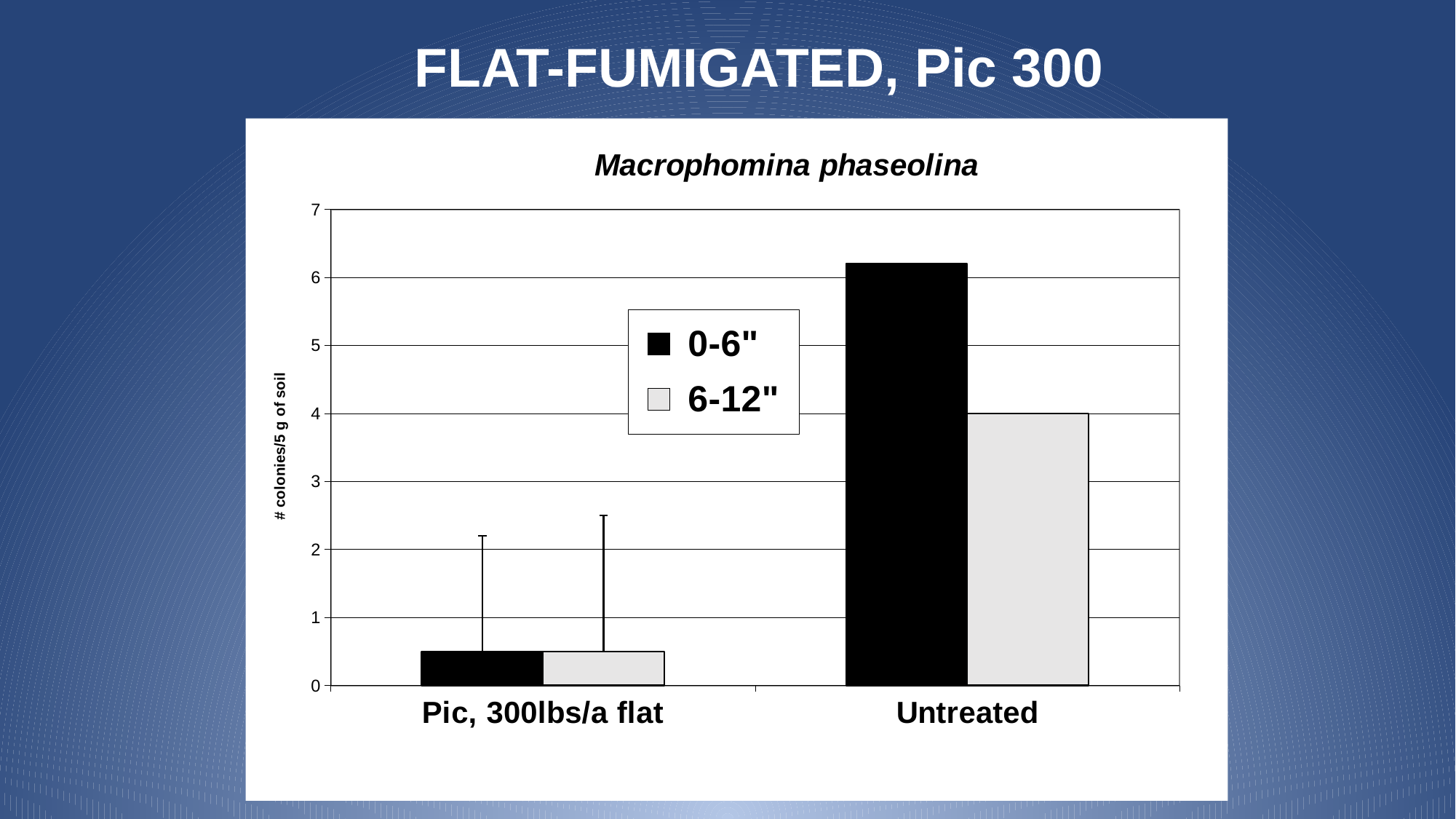
How many series does the chart's legend list? 2 What kind of chart is shown on the slide? bar chart What is the label on the chart's y axis? # colonies/5 g of soil What is the title of the chart? Macrophomina phaseolina Which category has the lowest value for the 6-12" series? Pic, 300lbs/a flat Which category has the highest value for the 0-6" series? Untreated For Untreated, which series has the larger value, 0-6" or 6-12"? 0-6" Is the 0-6" value for Pic, 300lbs/a flat greater or less than 1? less How many categories are shown on the x axis of the chart? 2 Is the 0-6" value for Untreated greater or less than 6? greater Which is larger: the 6-12" value for Untreated or the 6-12" value for Pic, 300lbs/a flat? Untreated Is the 6-12" value for Untreated greater or less than 3? greater